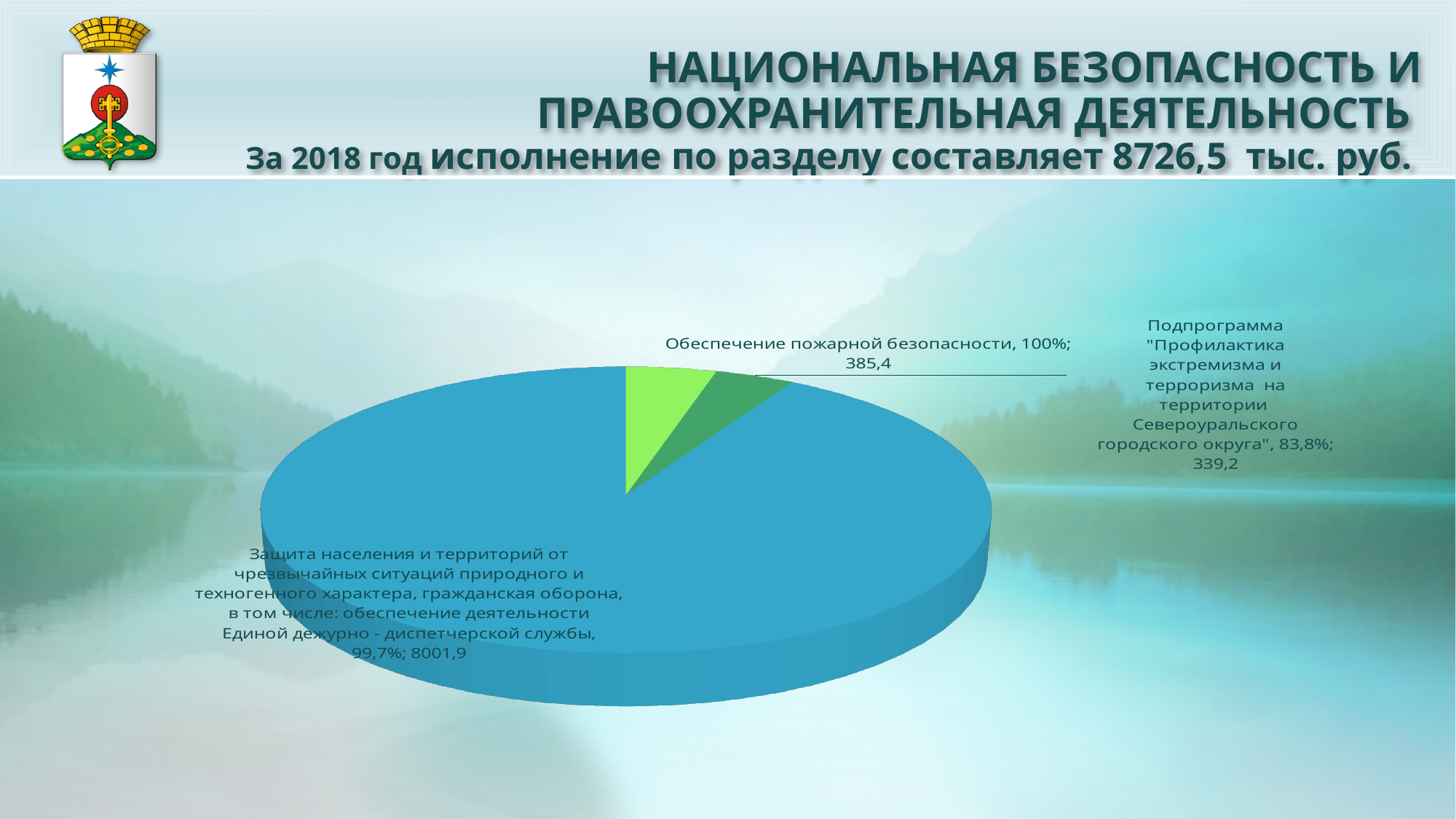
What is the difference between the values for "Обеспечение пожарной безопасности" and the subprogram "Профилактика экстремизма и терроризма"? 46,2 What value is shown for "Защита населения и территорий от чрезвычайных ситуаций природного и техногенного характера, гражданская оборона"? 8001,9 Which category has the smallest value in the pie chart? Подпрограмма "Профилактика экстремизма и терроризма на территории Североуральского городского округа" What value is shown for "Обеспечение пожарной безопасности"? 385,4 How many slices does the pie chart have? 3 What execution percentage is shown for "Обеспечение пожарной безопасности"? 100% Which category has the largest slice of the pie? Защита населения и территорий от чрезвычайных ситуаций природного и техногенного характера, гражданская оборона Which is larger: the value for "Обеспечение пожарной безопасности" or the value for the subprogram "Профилактика экстремизма и терроризма"? Обеспечение пожарной безопасности What kind of chart is shown on the slide? pie chart What value is shown for the subprogram "Профилактика экстремизма и терроризма на территории Североуральского городского округа"? 339,2 What execution percentage is shown for the subprogram "Профилактика экстремизма и терроризма"? 83,8% What colour is the slice for "Защита населения и территорий от чрезвычайных ситуаций"? blue